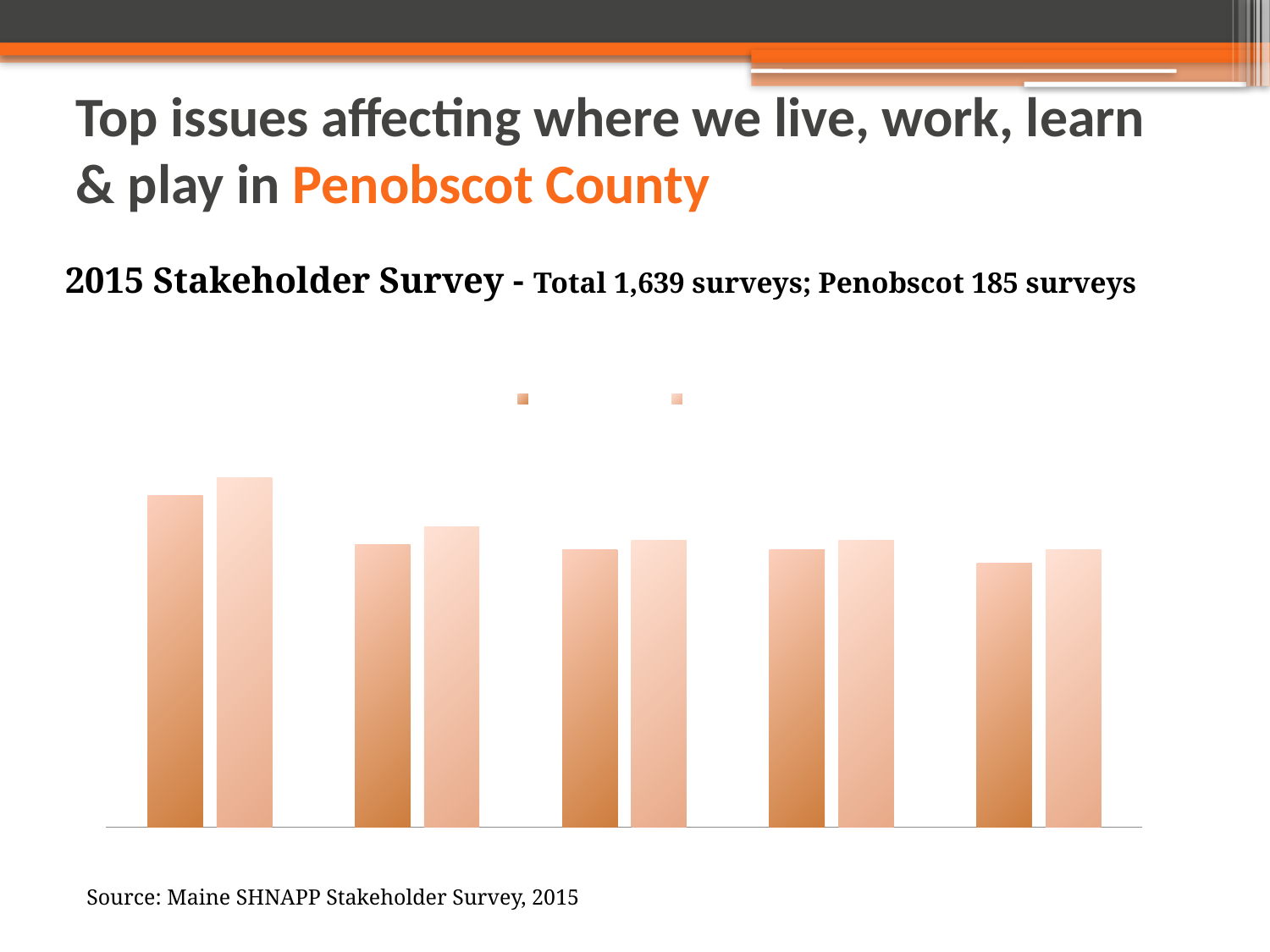
What kind of chart is shown on the slide? bar chart How many series does the chart's legend list? 2 Which group of bars, by position from the left, has the tallest bars? the first (leftmost) group Do the bar heights generally rise or fall from left to right across the chart? fall What colour are the bars in the chart? orange In each group, is the lighter bar taller or shorter than the darker bar? taller How many groups of bars are plotted in the chart? 5 Is the darker bar in the leftmost group taller or shorter than the darker bar in the rightmost group? taller Which group of bars, by position from the left, has the shortest bars? the fifth (rightmost) group